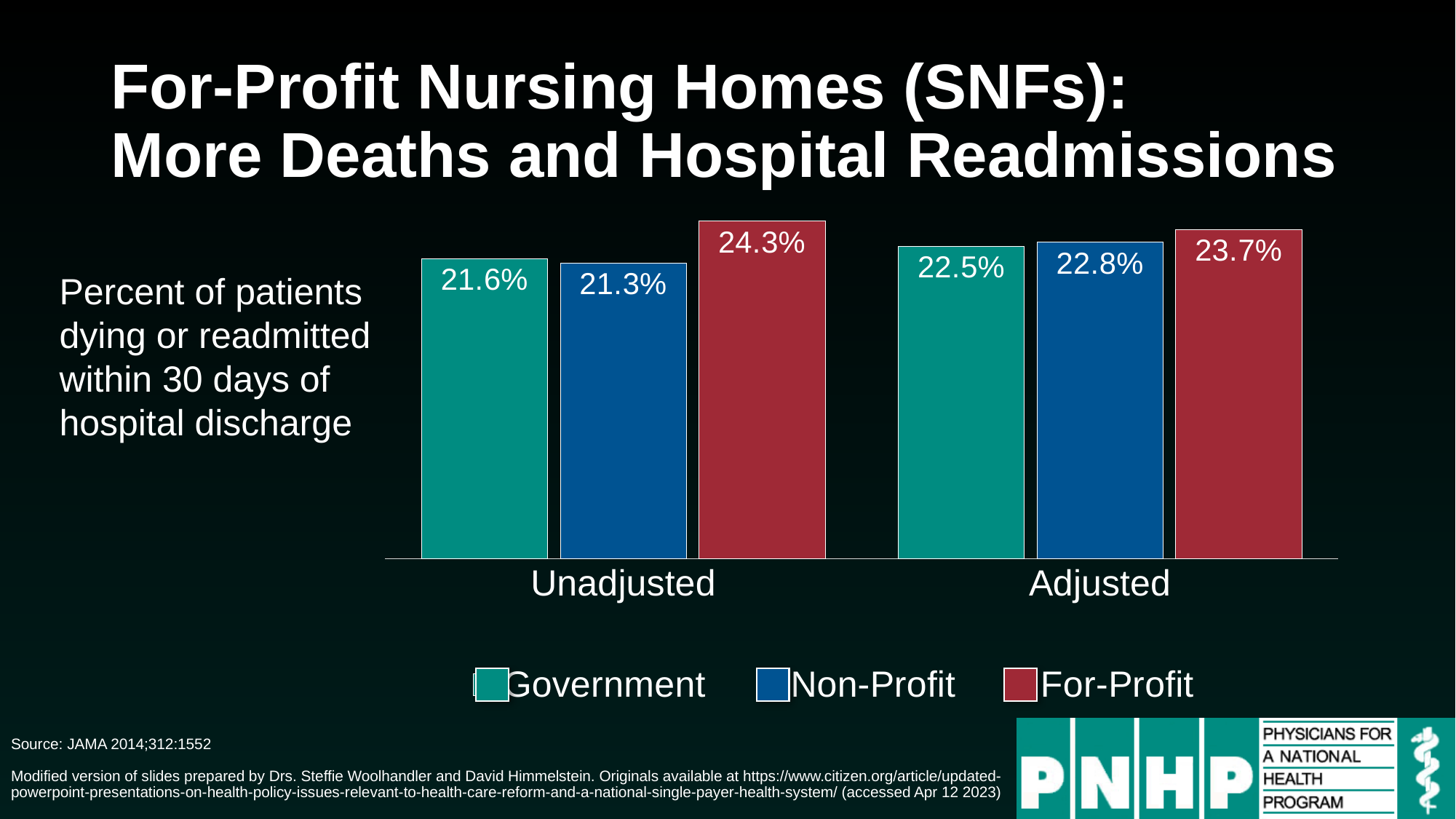
Which is larger, the Adjusted value for Non-Profit or the Adjusted value for Government? Non-Profit What is the Adjusted value for Government nursing homes? 22.5% What is the difference between the For-Profit and Government Adjusted values? 1.2% How many series does the legend list? 3 What is the Adjusted value for For-Profit nursing homes? 23.7% What kind of chart is shown on the slide? Bar chart What colour represents For-Profit in the legend? Red Which ownership type has the lowest Unadjusted value? Non-Profit Which ownership type has the highest Unadjusted value? For-Profit What is the Unadjusted value for Non-Profit nursing homes? 21.3% What is the difference between the For-Profit and Non-Profit Unadjusted values? 3.0% What is the Unadjusted value for For-Profit nursing homes? 24.3%